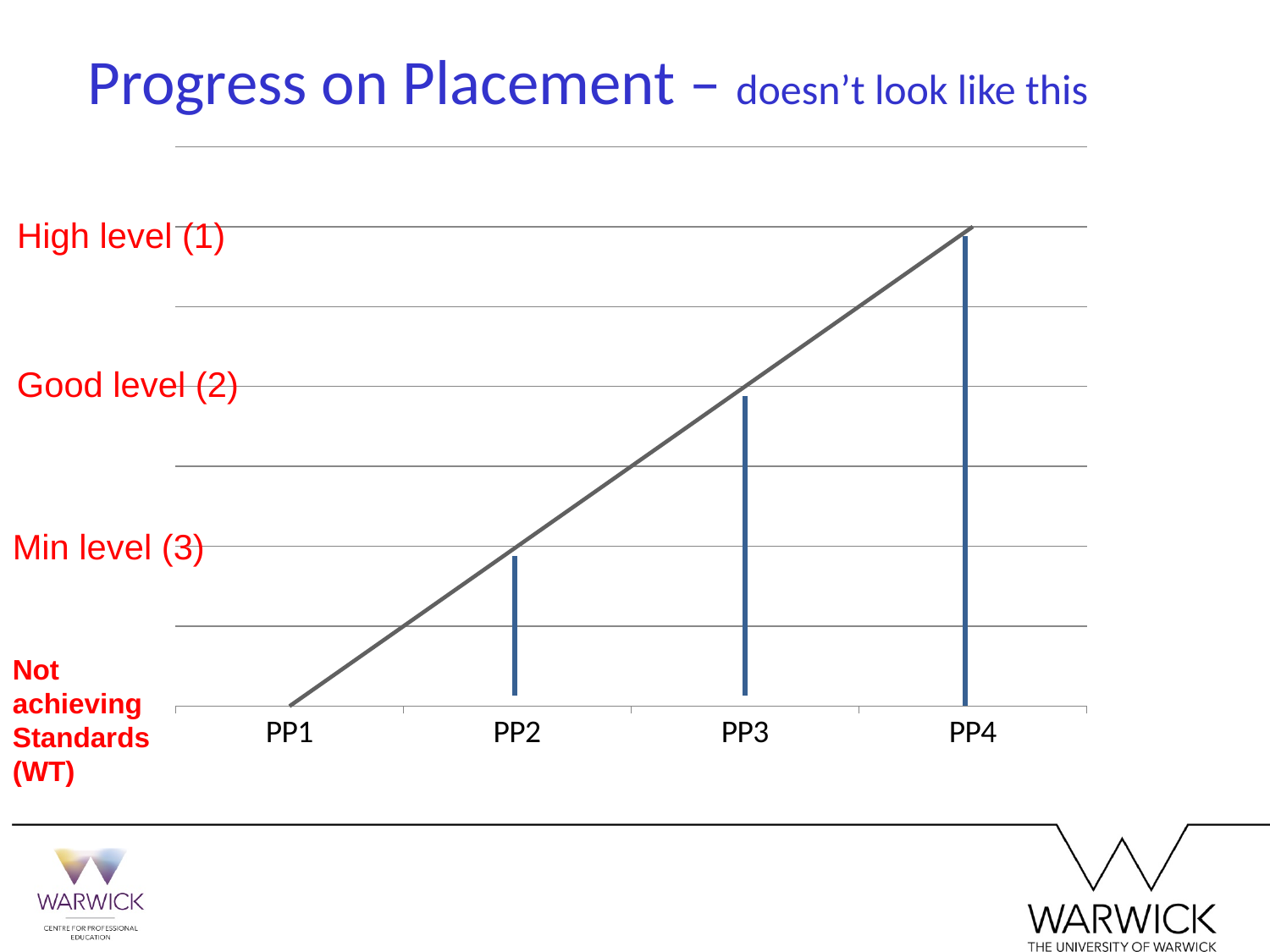
Which category has the lowest value? PP1 Which level on the y axis does the bar for PP2 reach? Min level (3) Which category has the tallest bar? PP4 How many categories are shown on the x axis? 4 Do the values rise or fall from PP1 to PP4? Rise What is the title of the slide? Progress on Placement – doesn't look like this What is the label of the first category on the x axis? PP1 Which is larger, the value for PP2 or the value for PP3? PP3 Which level on the y axis does the bar for PP4 reach? High level (1) What kind of chart is shown on the slide? Bar chart with a line Which level on the y axis does the bar for PP3 reach? Good level (2)